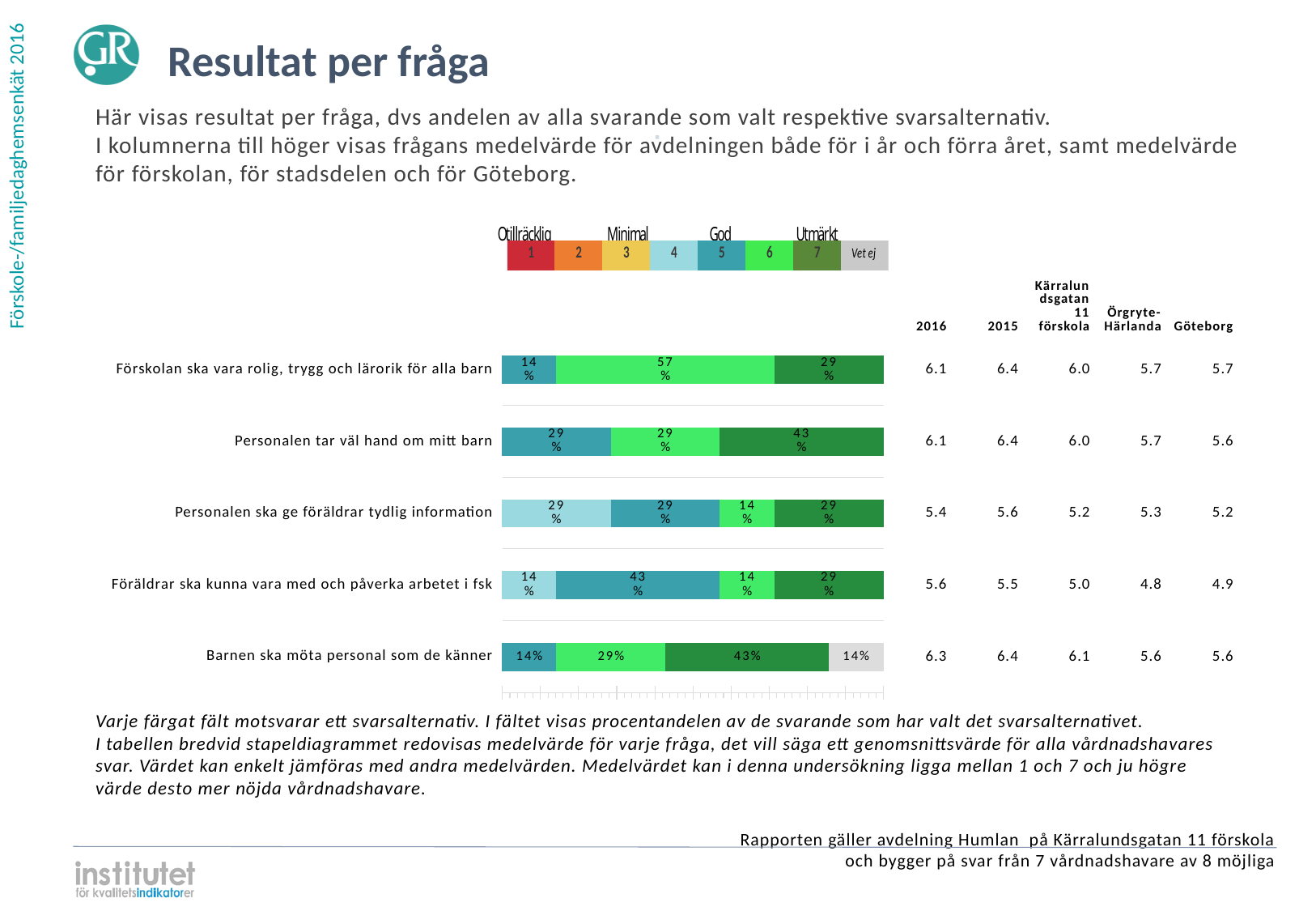
Which answer alternative has the largest share for 'Förskolan ska vara rolig, trygg och lärorik för alla barn'? 6 What is the difference between the share for answer 6 and the share for answer 7 in 'Förskolan ska vara rolig, trygg och lärorik för alla barn'? 28% How many questions (categories) are plotted in the bar chart? 5 What kind of chart is shown on the slide? Stacked bar chart What percentage of respondents chose answer 7 (dark green) for 'Personalen tar väl hand om mitt barn'? 43% Which colour in the legend represents answer alternative 7 (Utmärkt)? Dark green How many answer alternatives does the legend above the chart list? 8 For 'Personalen ska ge föräldrar tydlig information', is the share for answer 4 larger or smaller than the share for answer 6? Larger What percentage of respondents chose answer 5 for 'Föräldrar ska kunna vara med och påverka arbetet i fsk'? 43% What percentage of respondents chose answer 6 (light green) for 'Förskolan ska vara rolig, trygg och lärorik för alla barn'? 57% What percentage of respondents answered 'Vet ej' for 'Barnen ska möta personal som de känner'? 14% What is the 2016 mean value shown for 'Barnen ska möta personal som de känner'? 6.3